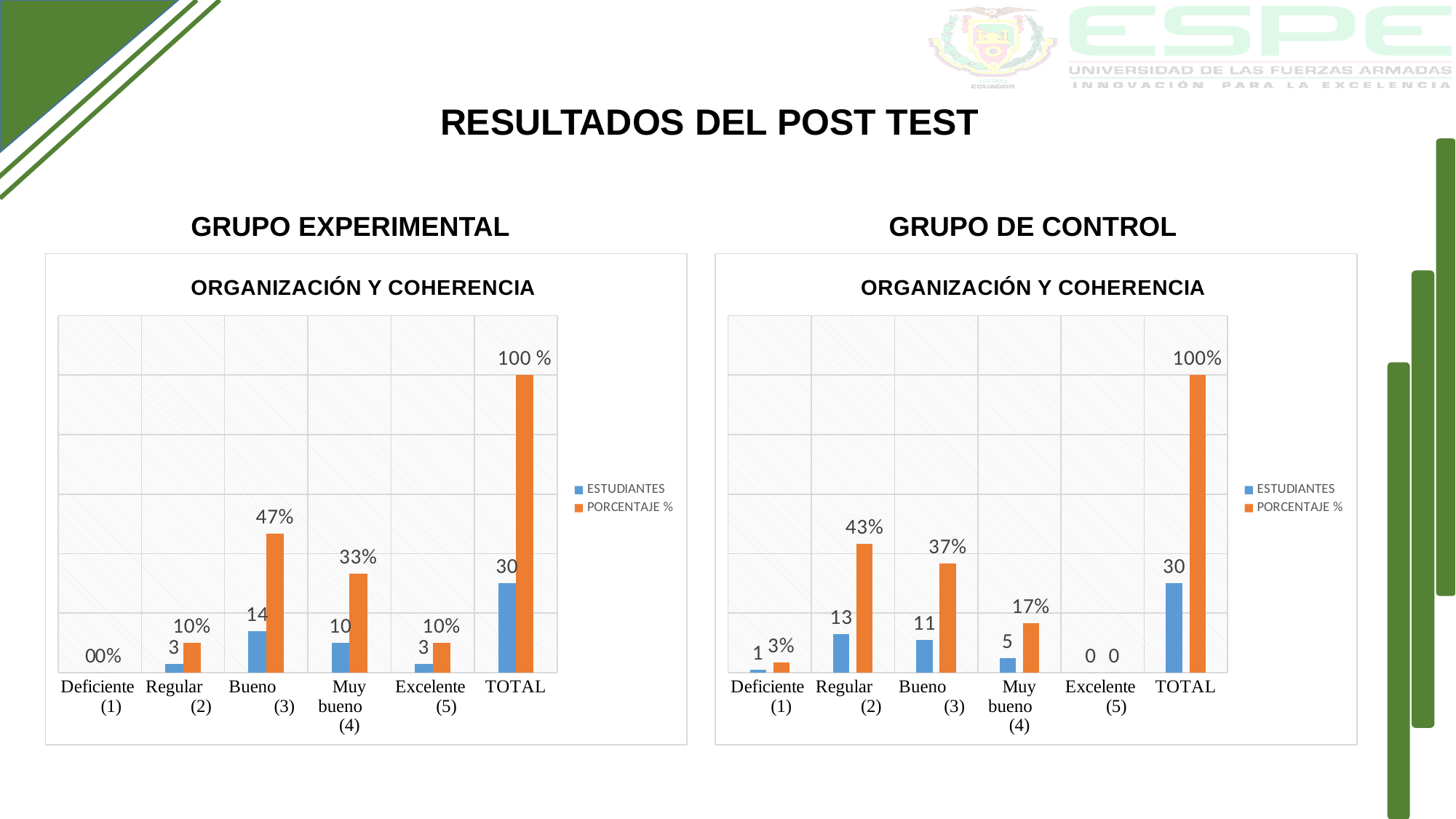
What type of chart is the GRUPO EXPERIMENTAL chart on the left? Bar chart In the GRUPO DE CONTROL chart on the right, what is the difference in ESTUDIANTES between Regular (2) and Bueno (3)? 2 Which has more ESTUDIANTES in the Bueno (3) category: the GRUPO EXPERIMENTAL chart or the GRUPO DE CONTROL chart? GRUPO EXPERIMENTAL In the GRUPO EXPERIMENTAL chart on the left, what is the difference in PORCENTAJE % between Bueno (3) and Muy bueno (4)? 14% In the GRUPO DE CONTROL chart on the right, what is the PORCENTAJE % for Regular (2)? 43% In the GRUPO DE CONTROL chart on the right, excluding TOTAL, which category has the highest number of ESTUDIANTES? Regular (2) In the GRUPO EXPERIMENTAL chart on the left, excluding TOTAL, which category has the highest PORCENTAJE %? Bueno (3) In the GRUPO EXPERIMENTAL chart on the left, which category has the lowest number of ESTUDIANTES? Deficiente (1) In the GRUPO DE CONTROL chart on the right, how many ESTUDIANTES are in the Muy bueno (4) category? 5 In the GRUPO EXPERIMENTAL chart on the left, what is the PORCENTAJE % for Muy bueno (4)? 33% How many series does the legend of the GRUPO DE CONTROL chart on the right list? 2 In the GRUPO EXPERIMENTAL chart on the left, how many ESTUDIANTES are in the Bueno (3) category? 14